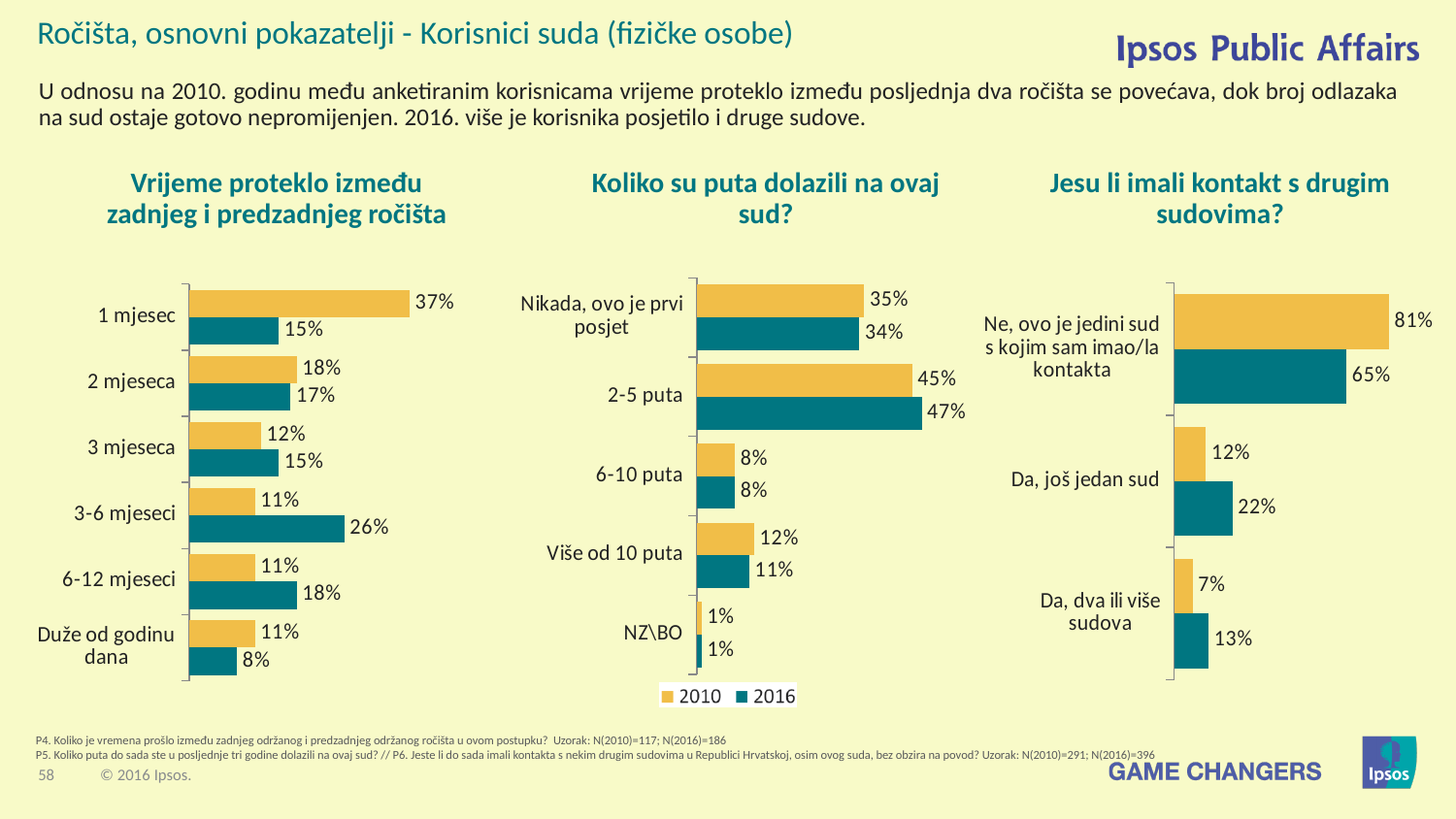
How many categories are shown in the chart 'Vrijeme proteklo između zadnjeg i predzadnjeg ročišta'? 6 In the chart 'Koliko su puta dolazili na ovaj sud?', which category has the lowest 2010 value? NZ\BO In the chart 'Jesu li imali kontakt s drugim sudovima?', what is the 2010 value for 'Ne, ovo je jedini sud s kojim sam imao/la kontakta'? 81% In the chart 'Vrijeme proteklo između zadnjeg i predzadnjeg ročišta', what is the difference between the 2010 and 2016 values for '1 mjesec'? 22 percentage points How many series does the legend list in the chart 'Koliko su puta dolazili na ovaj sud?'? 2 In the chart 'Vrijeme proteklo između zadnjeg i predzadnjeg ročišta', what is the 2016 value for '3-6 mjeseci'? 26% In the chart 'Koliko su puta dolazili na ovaj sud?', what is the 2016 value for '2-5 puta'? 47% In the chart 'Jesu li imali kontakt s drugim sudovima?', what is the difference between the 2016 and 2010 values for 'Da, još jedan sud'? 10 percentage points What type of chart is 'Jesu li imali kontakt s drugim sudovima?'? Bar chart In the chart 'Koliko su puta dolazili na ovaj sud?', is the 2010 value for 'Nikada, ovo je prvi posjet' larger or smaller than the 2016 value? larger In the chart 'Vrijeme proteklo između zadnjeg i predzadnjeg ročišta', what is the 2010 value for '1 mjesec'? 37% In the chart 'Vrijeme proteklo između zadnjeg i predzadnjeg ročišta', which category has the highest 2016 value? 3-6 mjeseci